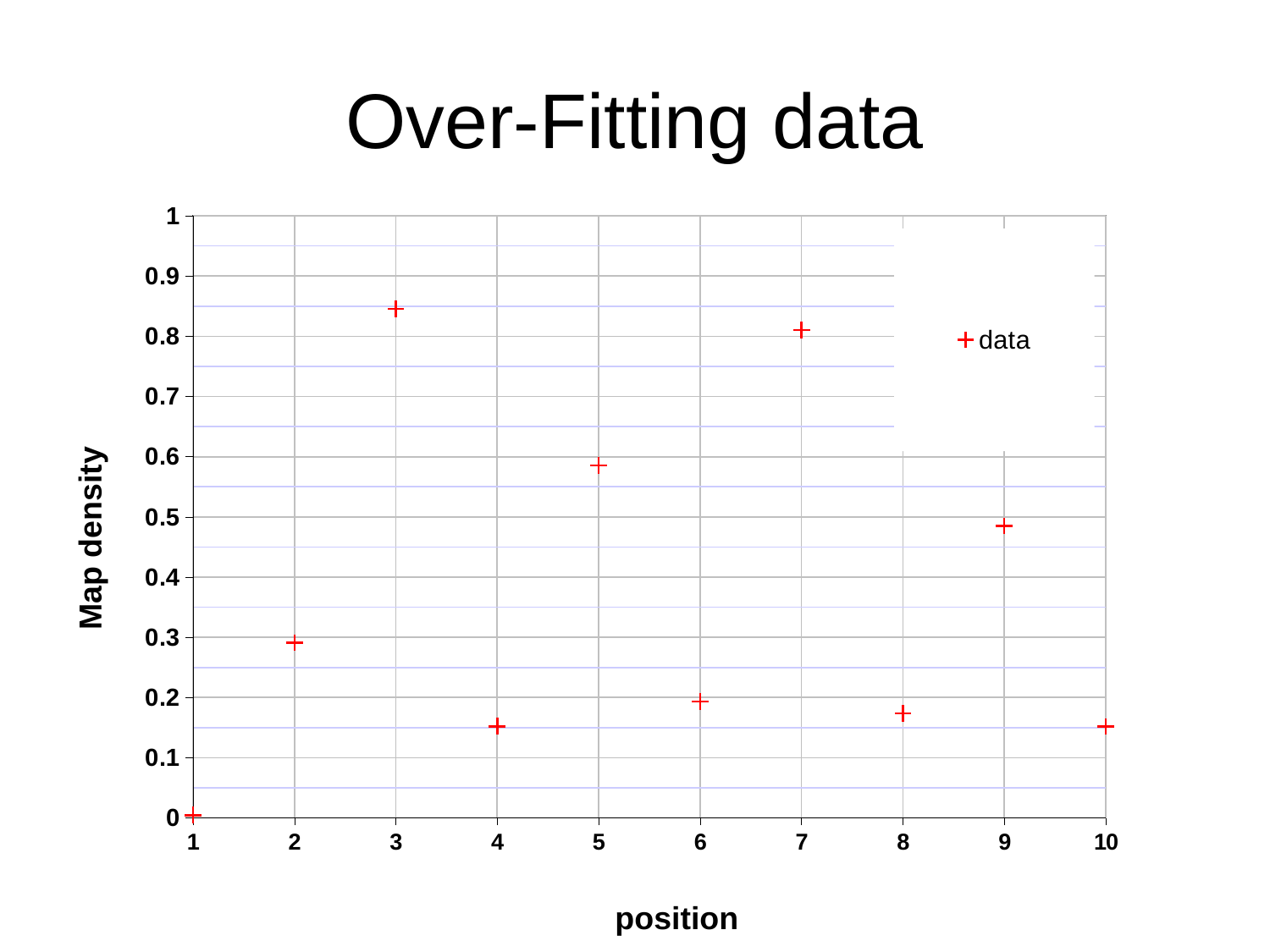
Is the Map density at position 7 greater or less than 0.7? greater What is the label of the y axis? Map density At which position is the Map density lowest? 1 At which position is the Map density highest? 3 What is the title of the chart? Over-Fitting data Is the Map density at position 2 greater or less than 0.4? less Which has the larger Map density, position 5 or position 9? position 5 How many series does the legend list? 1 What kind of chart is shown on the slide? scatter chart Is the Map density at position 4 greater or less than 0.2? less How many data points are plotted in the chart? 10